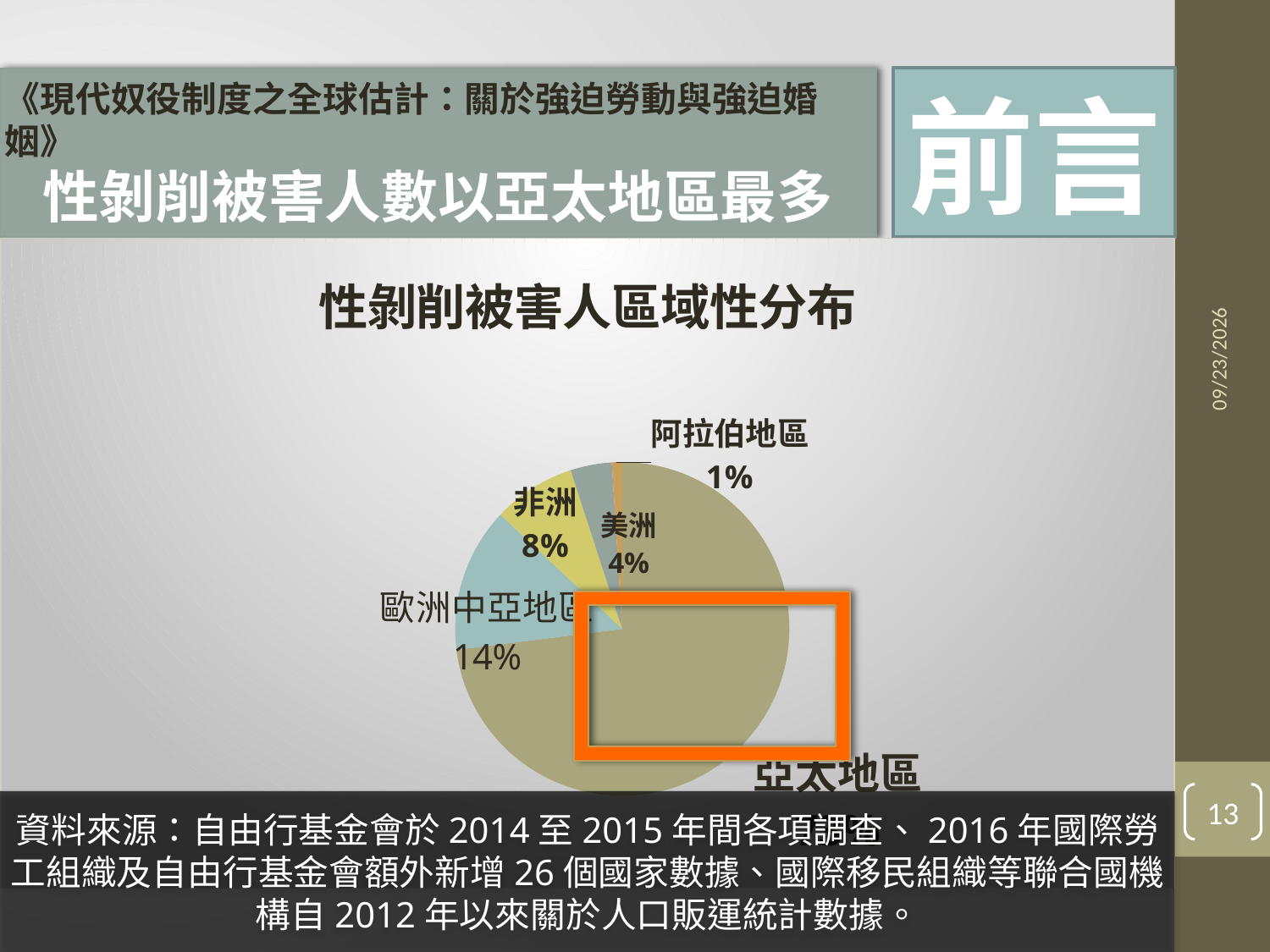
What percentage is shown for 阿拉伯地區? 1% What percentage is shown for 非洲? 8% What percentage is shown for 歐洲中亞地區? 14% Which is larger, the share for 非洲 or the share for 美洲? 非洲 What kind of chart is shown on the slide? pie chart Which region has the largest slice of the pie? 亞太地區 What is the title of the chart? 性剝削被害人區域性分布 What is the difference in percentage points between 歐洲中亞地區 and 非洲? 6 What percentage is shown for 美洲? 4% What is the difference in percentage points between 非洲 and 美洲? 4 How many regions (slices) does the pie chart show? 5 Which region has the smallest slice of the pie? 阿拉伯地區